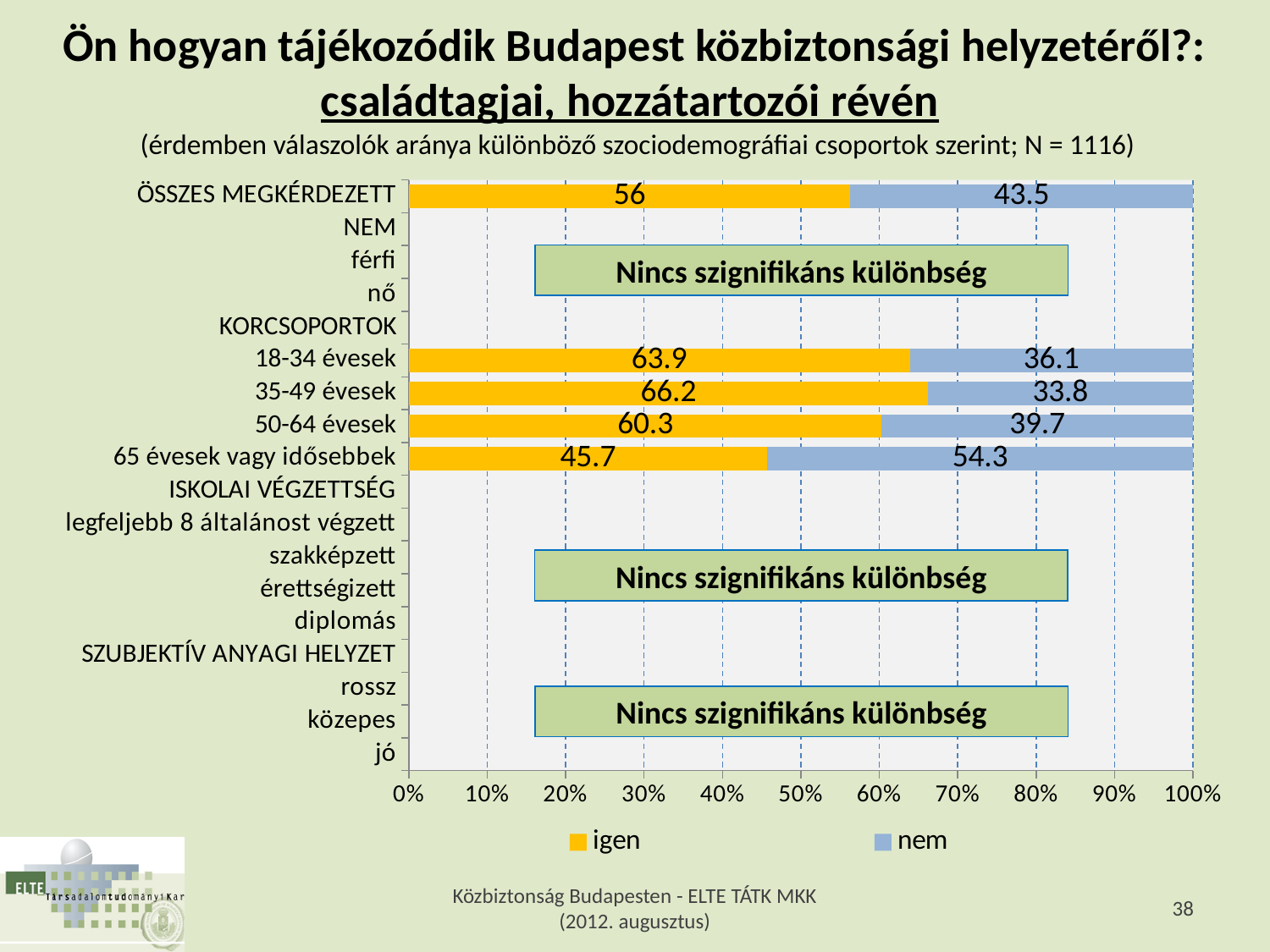
What is the difference between the 'igen' values for 18-34 évesek and 50-64 évesek? 3.6 What is the 'igen' value for 35-49 évesek? 66.2 What is the total of the stacked bar for 18-34 évesek? 100 What text is shown in the green boxes where no bars are plotted? Nincs szignifikáns különbség Among the age groups with plotted bars, which has the highest 'igen' value? 35-49 évesek What is the 'nem' value for 65 évesek vagy idősebbek? 54.3 What is the 'nem' value for 50-64 évesek? 39.7 Which is larger: the 'nem' value for 18-34 évesek or for 35-49 évesek? 18-34 évesek How many series does the legend list? 2 What is the 'igen' value for ÖSSZES MEGKÉRDEZETT? 56 Among the age groups with plotted bars, which has the lowest 'igen' value? 65 évesek vagy idősebbek What kind of chart is shown on the slide? Stacked bar chart